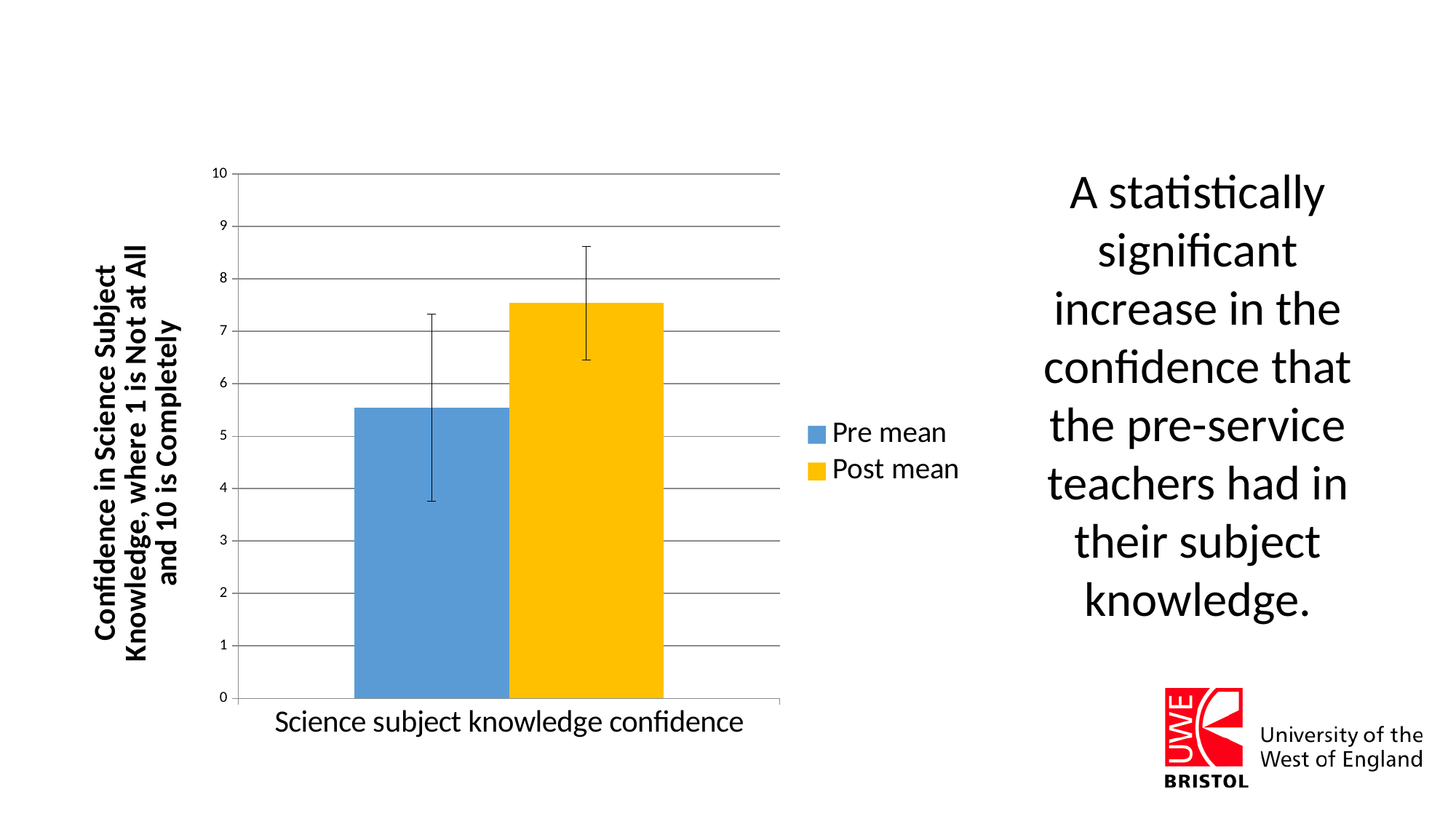
What kind of chart is shown on the slide? bar chart Which series has the higher value, Pre mean or Post mean? Post mean Which series has the lowest bar? Pre mean How many series does the legend list? 2 What is the category label on the x axis? Science subject knowledge confidence Which series has the highest bar? Post mean Is the value for Post mean greater or less than 7? greater How many categories are shown on the x axis? 1 Is the value for Post mean greater or less than 8? less What colour is the Post mean bar? yellow Is the value for Pre mean greater or less than 6? less